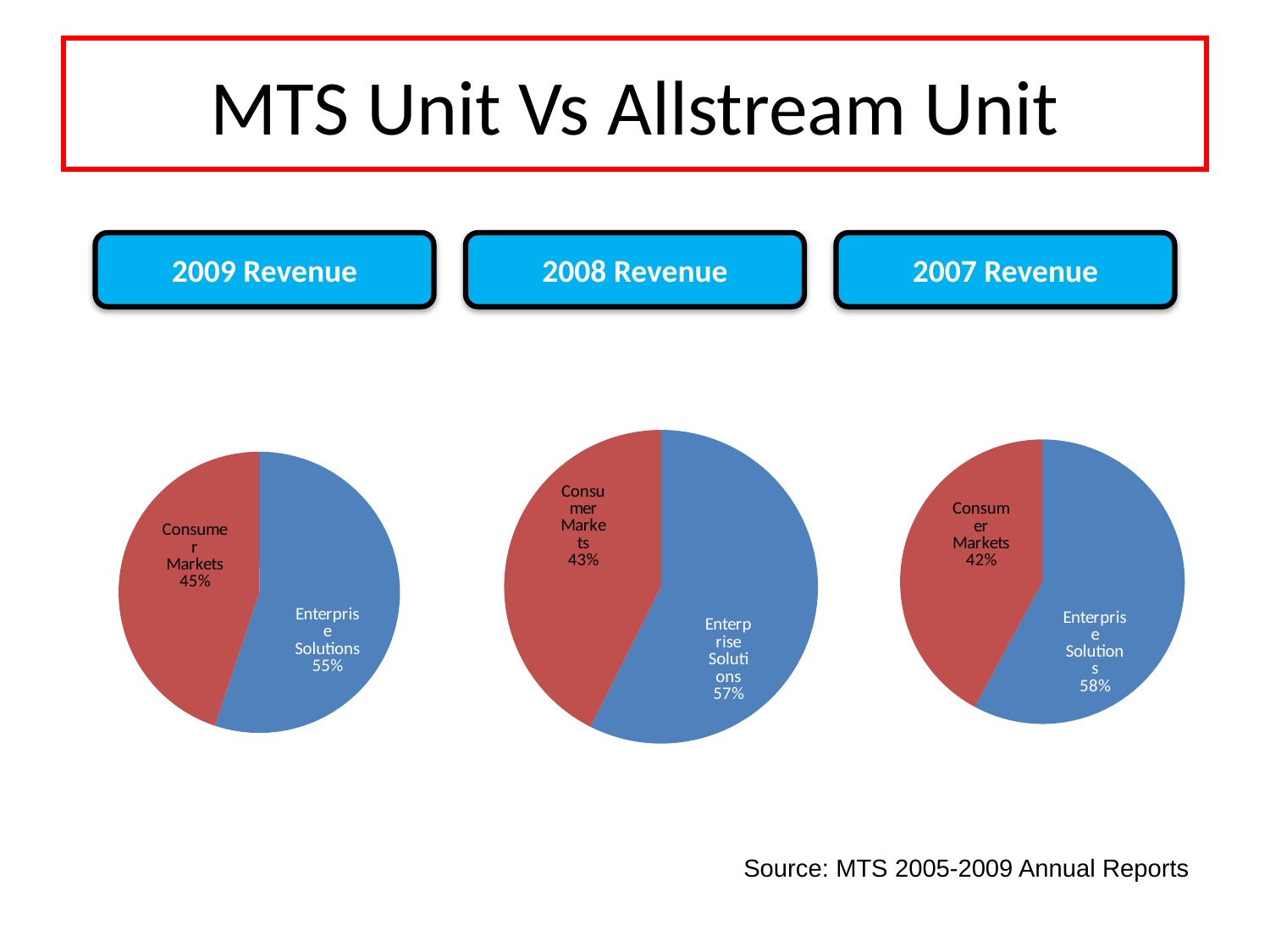
In the 2009 Revenue pie chart, what is the difference between the Enterprise Solutions share and the Consumer Markets share? 10% In the 2009 Revenue pie chart, what share does Consumer Markets have? 45% In the 2009 Revenue pie chart, what share does Enterprise Solutions have? 55% Which is larger: the Consumer Markets share in the 2009 Revenue chart or in the 2007 Revenue chart? 2009 Revenue How many slices does the 2008 Revenue pie chart have? 2 In the 2008 Revenue pie chart, which slice is the smallest? Consumer Markets In the 2007 Revenue pie chart, what share does Consumer Markets have? 42% In the 2008 Revenue pie chart, what share does Consumer Markets have? 43% In the 2007 Revenue pie chart, what share does Enterprise Solutions have? 58% In the 2007 Revenue pie chart, which slice is the largest? Enterprise Solutions What type of chart is used to show the 2007 Revenue? Pie chart In the 2008 Revenue pie chart, what share does Enterprise Solutions have? 57%